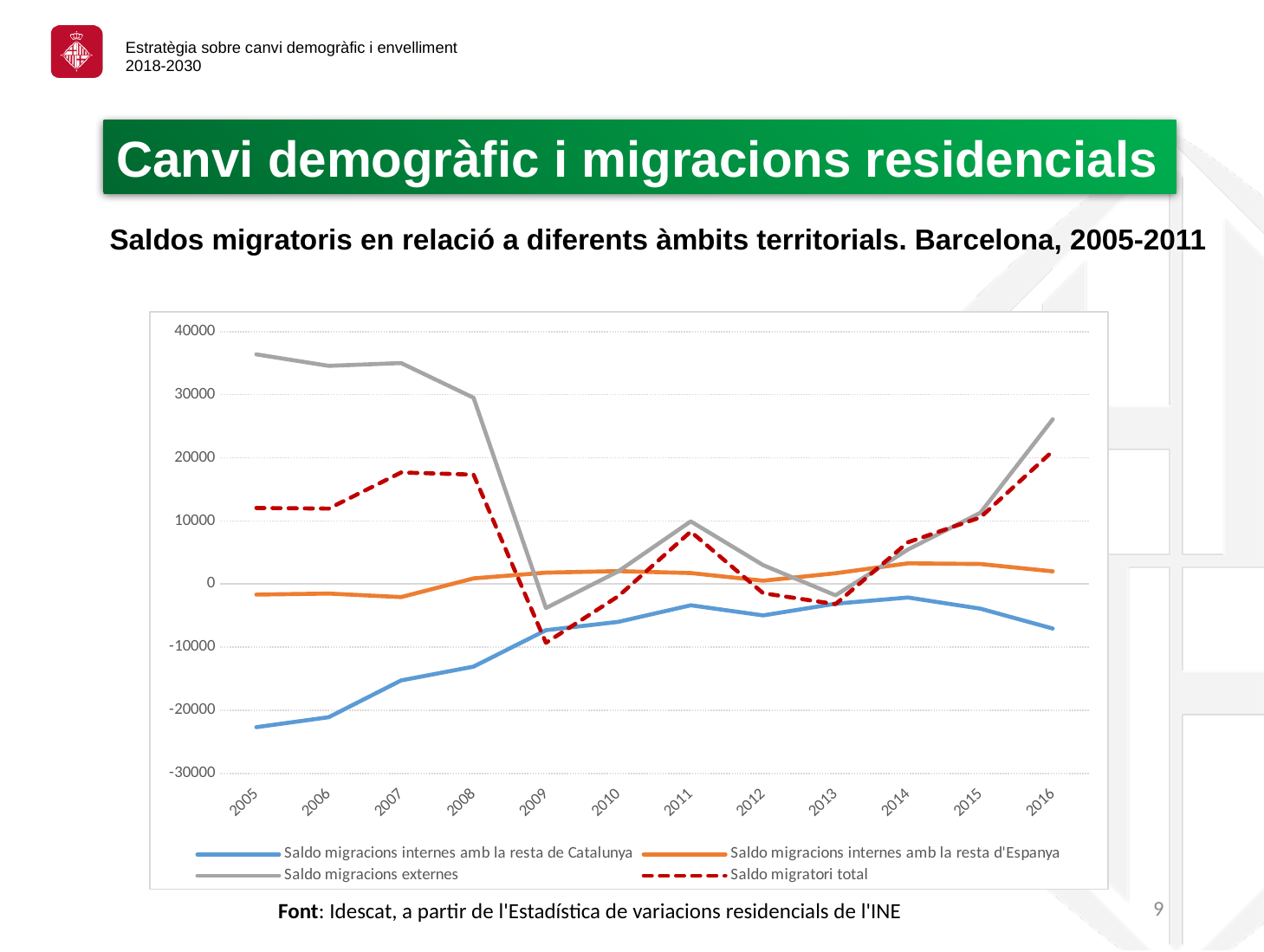
How many series does the legend list? 4 Is the value for Saldo migracions externes in 2016 greater or less than 20000? greater Is the value for Saldo migratori total in 2009 greater or less than 0? less Is the value for Saldo migracions externes in 2005 greater or less than 30000? greater Which series is drawn as a dashed line? Saldo migratori total What kind of chart is shown on the slide? line chart In which year is Saldo migracions externes at its lowest? 2009 In 2016, which is larger: Saldo migracions externes or Saldo migratori total? Saldo migracions externes In which year is Saldo migracions internes amb la resta de Catalunya at its lowest? 2005 In which year is Saldo migratori total at its highest? 2016 How many years are plotted along the x axis? 12